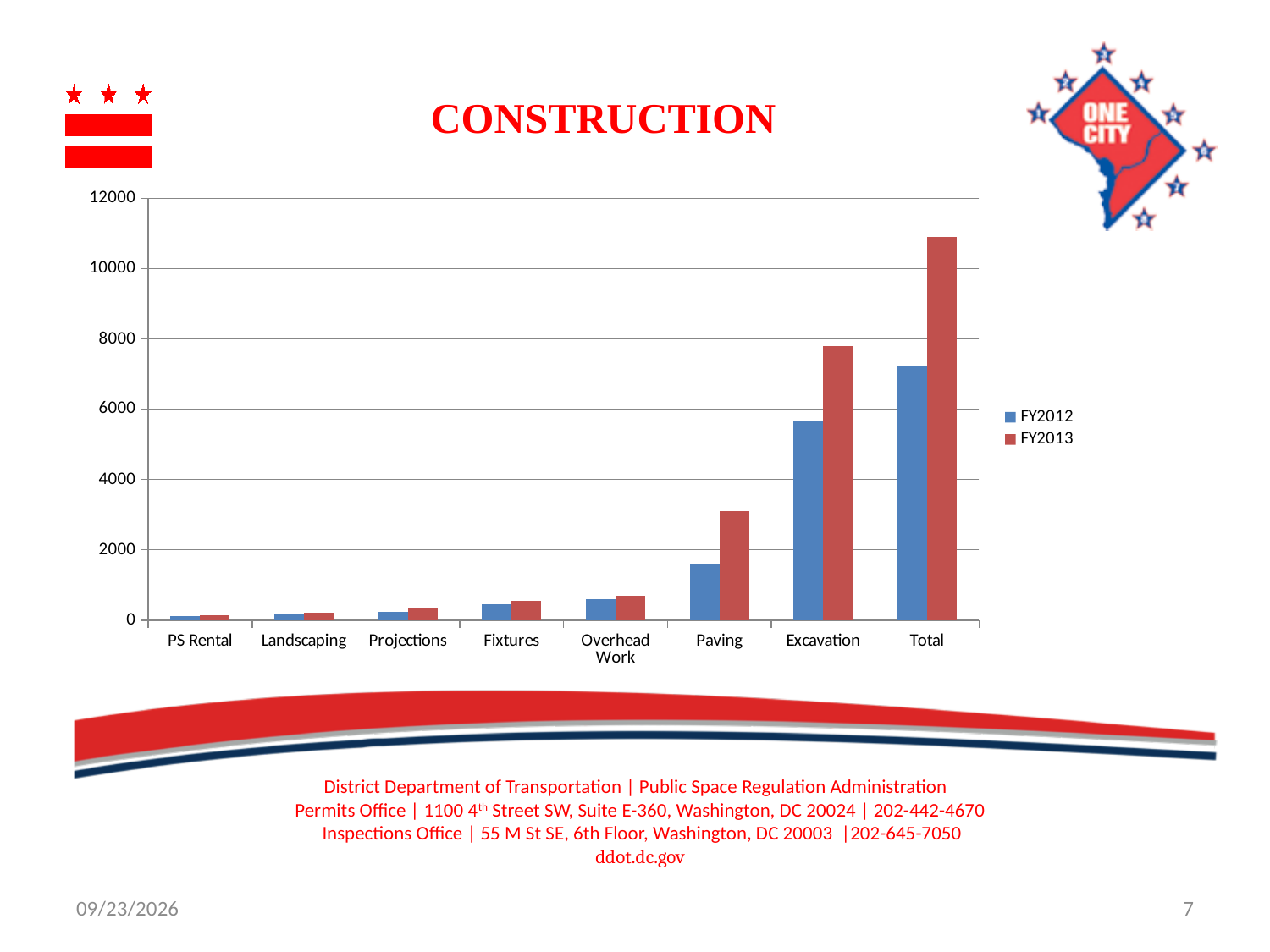
Is the FY2012 value for Total greater or less than 8000? less How many series does the legend list? 2 Do the FY2013 values generally rise or fall moving from PS Rental to Total along the x axis? rise Is the FY2013 value for Excavation greater or less than 6000? greater Which category has the highest FY2013 value? Total Is the FY2013 value for Paving greater or less than 2000? greater How many categories are shown on the x axis? 8 What is the title of the chart? CONSTRUCTION For Excavation, which series has the larger value, FY2012 or FY2013? FY2013 What kind of chart is shown on the slide? bar chart Which category has the lowest FY2012 value? PS Rental